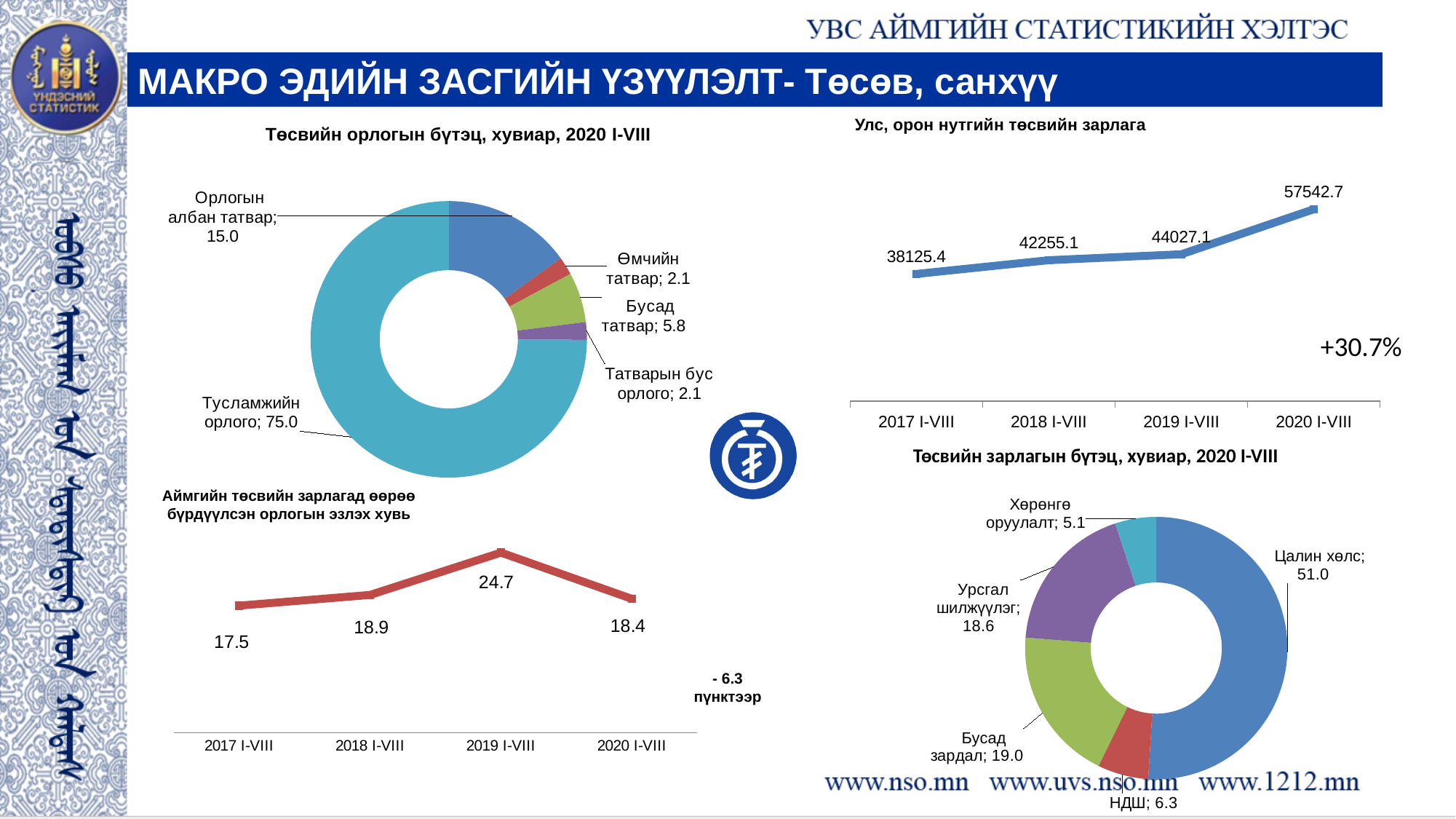
In the chart 'Улс, орон нутгийн төсвийн зарлага', do the values rise or fall from 2017 I-VIII to 2020 I-VIII? rise In the chart 'Улс, орон нутгийн төсвийн зарлага', what is the difference between the values for 2020 I-VIII and 2019 I-VIII? 13515.6 In the chart 'Төсвийн орлогын бүтэц, хувиар, 2020 I-VIII', how many categories are shown? 5 In the chart 'Төсвийн орлогын бүтэц, хувиар, 2020 I-VIII', which category has the smallest share among those labelled Орлогын албан татвар, Бусад татвар and Тусламжийн орлого? Бусад татвар In the chart 'Төсвийн зарлагын бүтэц, хувиар, 2020 I-VIII', what is the difference between Бусад зардал and Урсгал шилжүүлэг? 0.4 In the chart 'Төсвийн зарлагын бүтэц, хувиар, 2020 I-VIII', what is the value for Цалин хөлс? 51.0 What kind of chart is 'Улс, орон нутгийн төсвийн зарлага'? line chart In the chart 'Аймгийн төсвийн зарлагад өөрөө бүрдүүлсэн орлогын эзлэх хувь', what is the value for 2017 I-VIII? 17.5 In the chart 'Аймгийн төсвийн зарлагад өөрөө бүрдүүлсэн орлогын эзлэх хувь', which is larger, the value for 2018 I-VIII or 2020 I-VIII? 2018 I-VIII In the chart 'Улс, орон нутгийн төсвийн зарлага', what is the value for 2020 I-VIII? 57542.7 In the chart 'Аймгийн төсвийн зарлагад өөрөө бүрдүүлсэн орлогын эзлэх хувь', which period has the highest value? 2019 I-VIII In the chart 'Төсвийн орлогын бүтэц, хувиар, 2020 I-VIII', what is the value for Тусламжийн орлого? 75.0